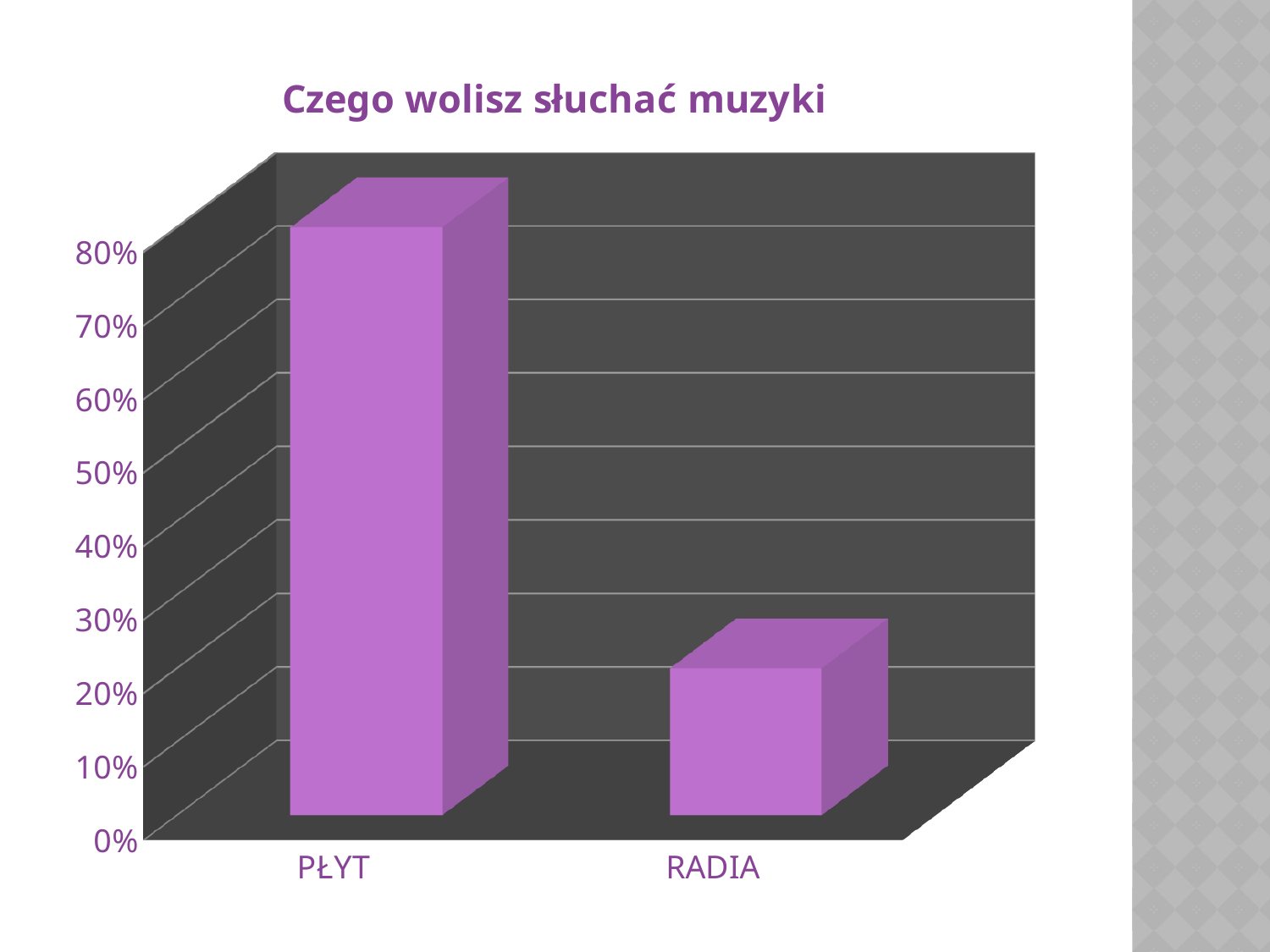
What is the title of the chart? Czego wolisz słuchać muzyki Do the values rise or fall from PŁYT to RADIA along the x axis? fall Which category has the highest value? PŁYT Which is larger, the value for PŁYT or the value for RADIA? PŁYT What colour are the bars in the chart? purple Is the value for PŁYT greater or less than 60%? greater Which category has the lowest value? RADIA How many categories are shown on the x axis? 2 Is the value for PŁYT greater or less than 50%? greater Is the value for RADIA greater or less than 40%? less What kind of chart is shown on the slide? bar chart